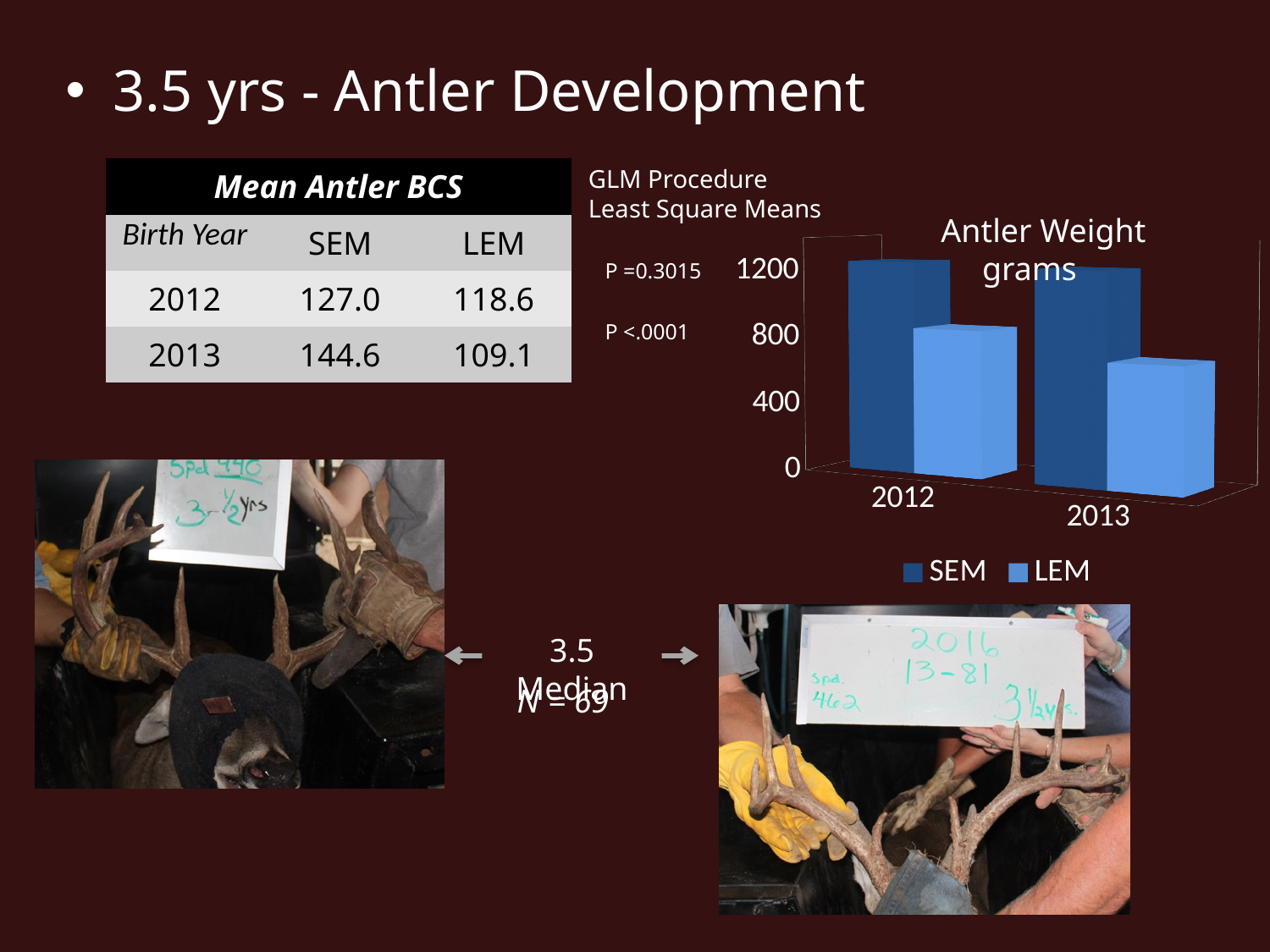
In the Antler Weight chart, is the LEM value for 2013 greater or less than 400? greater How many series does the legend of the Antler Weight chart list? 2 What is the title of the bar chart on the slide? Antler Weight grams What are the two series named in the legend of the Antler Weight chart? SEM and LEM In the Antler Weight chart, which series has the larger value for 2012, SEM or LEM? SEM In the Antler Weight chart, does the LEM value rise or fall from 2012 to 2013? fall In the Antler Weight chart, is the SEM value for 2012 greater or less than 800? greater In the Antler Weight chart, is the SEM value for 2013 greater or less than 800? greater How many birth-year categories are shown on the x axis of the Antler Weight chart? 2 In the Antler Weight chart, which bar is the lowest? LEM for 2013 What kind of chart is the Antler Weight chart? bar chart